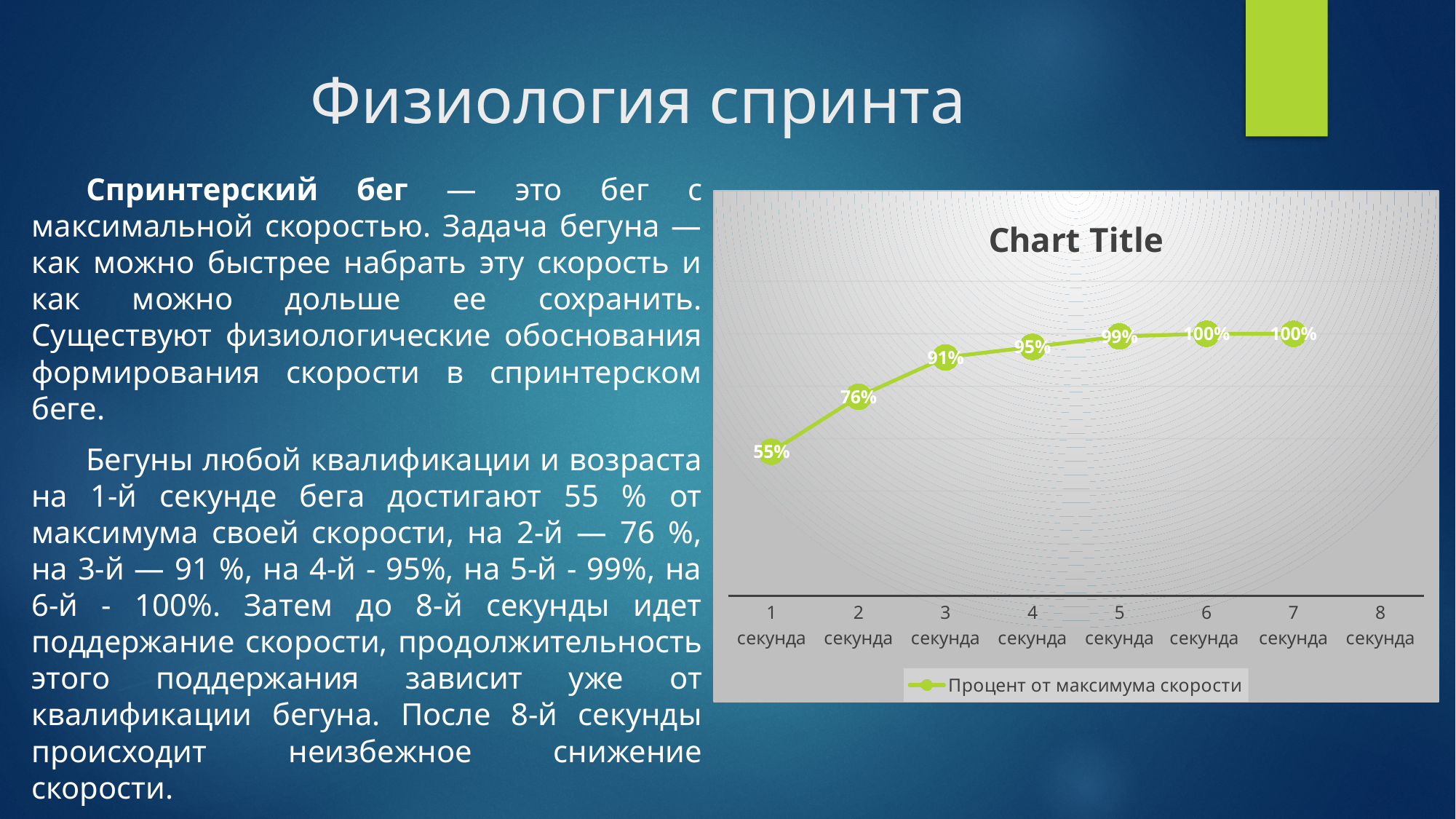
What is the value for 5 секунда? 99% What is the value for 6 секунда? 100% What type of chart is shown on the slide? line chart What is the value for 1 секунда? 55% How many categories are labelled on the x axis? 8 What is the difference between the values for 2 секунда and 1 секунда? 21% Which category has the lowest value? 1 секунда Which is larger, the value for 3 секунда or the value for 4 секунда? 4 секунда What is the value for 2 секунда? 76% What is the value for 3 секунда? 91% Do the values rise or fall from 1 секунда to 6 секунда? rise How many series does the legend list? 1